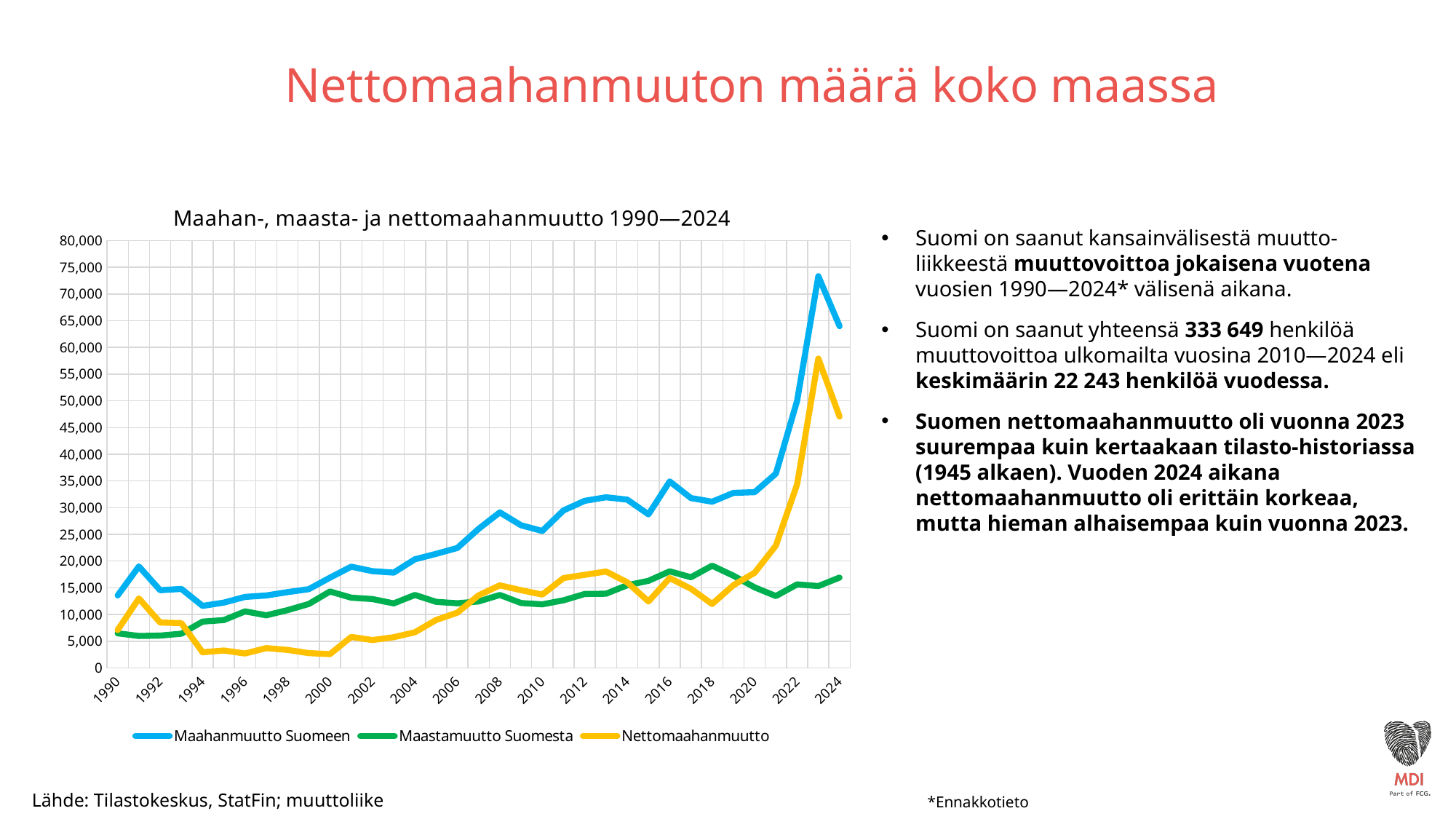
Is the value for Maahanmuutto Suomeen in 2023 greater or less than 70,000? greater In which year does Maahanmuutto Suomeen reach its highest value? 2023 Is the value for Maastamuutto Suomesta in 2024 greater or less than 20,000? less Is the value for Nettomaahanmuutto in 2023 greater or less than 55,000? greater In which year does Nettomaahanmuutto reach its highest value? 2023 Does Maahanmuutto Suomeen rise or fall between 2020 and 2023? Rise What kind of chart is shown on the slide? Line chart In 2018, which is larger: Maastamuutto Suomesta or Nettomaahanmuutto? Maastamuutto Suomesta What is the title of the chart? Maahan-, maasta- ja nettomaahanmuutto 1990—2024 How many series does the legend list? 3 Which colour is used for the Nettomaahanmuutto line? Yellow